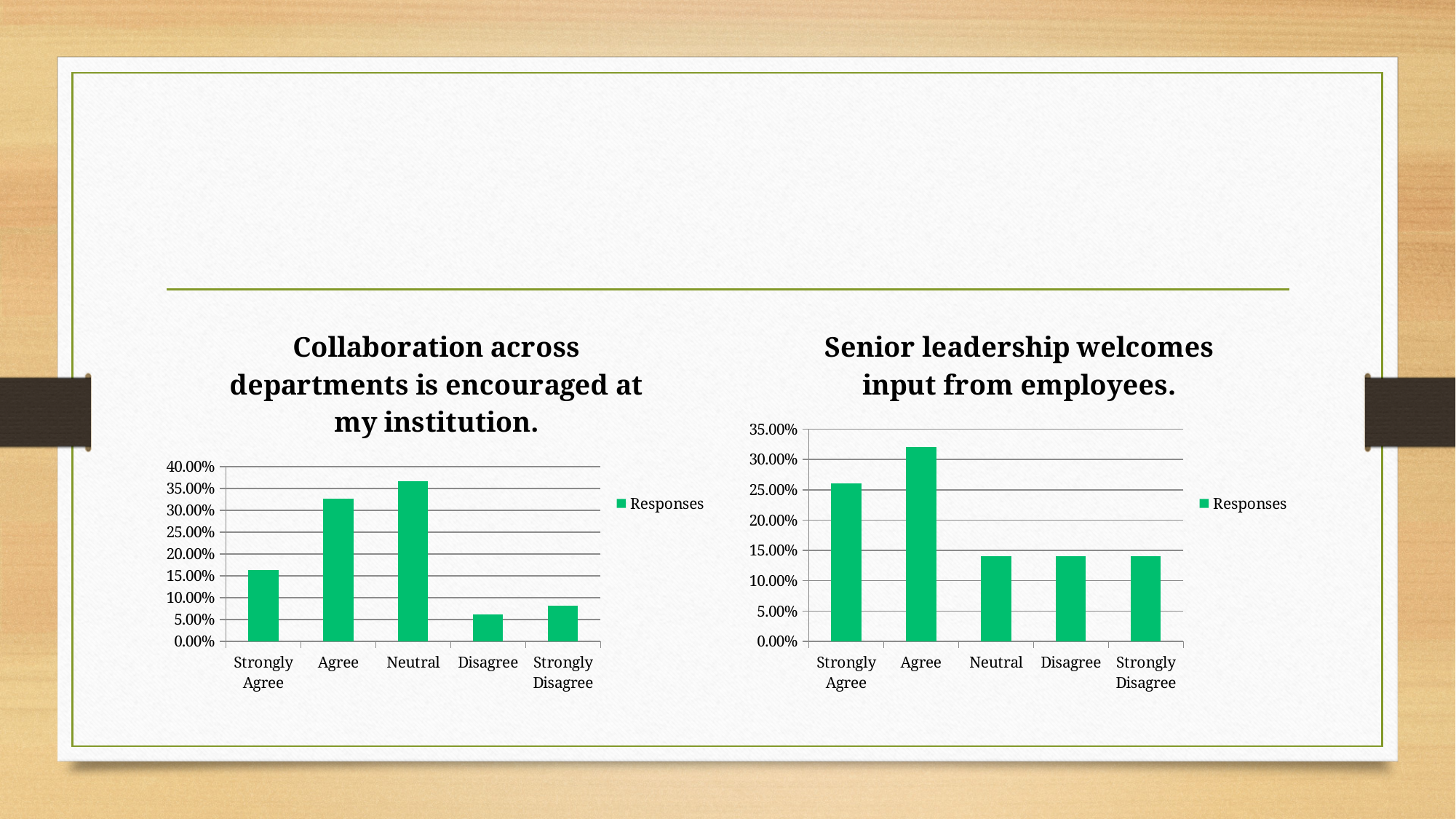
In the chart titled "Collaboration across departments is encouraged at my institution.", which category has the lowest value? Disagree How many series does the legend list in the chart titled "Senior leadership welcomes input from employees."? 1 In the chart titled "Collaboration across departments is encouraged at my institution.", which category has the highest value? Neutral What kind of chart is the chart titled "Collaboration across departments is encouraged at my institution."? bar chart How many categories are shown on the x axis of the chart titled "Senior leadership welcomes input from employees."? 5 In the chart titled "Collaboration across departments is encouraged at my institution.", is the value for Neutral greater or less than 35.00%? greater In the chart titled "Senior leadership welcomes input from employees.", is the value for Agree greater or less than 30.00%? greater In the chart titled "Collaboration across departments is encouraged at my institution.", is the value for Strongly Agree greater or less than 20.00%? less In the chart titled "Collaboration across departments is encouraged at my institution.", which is larger, the value for Agree or the value for Strongly Agree? Agree In the chart titled "Senior leadership welcomes input from employees.", which category has the highest value? Agree